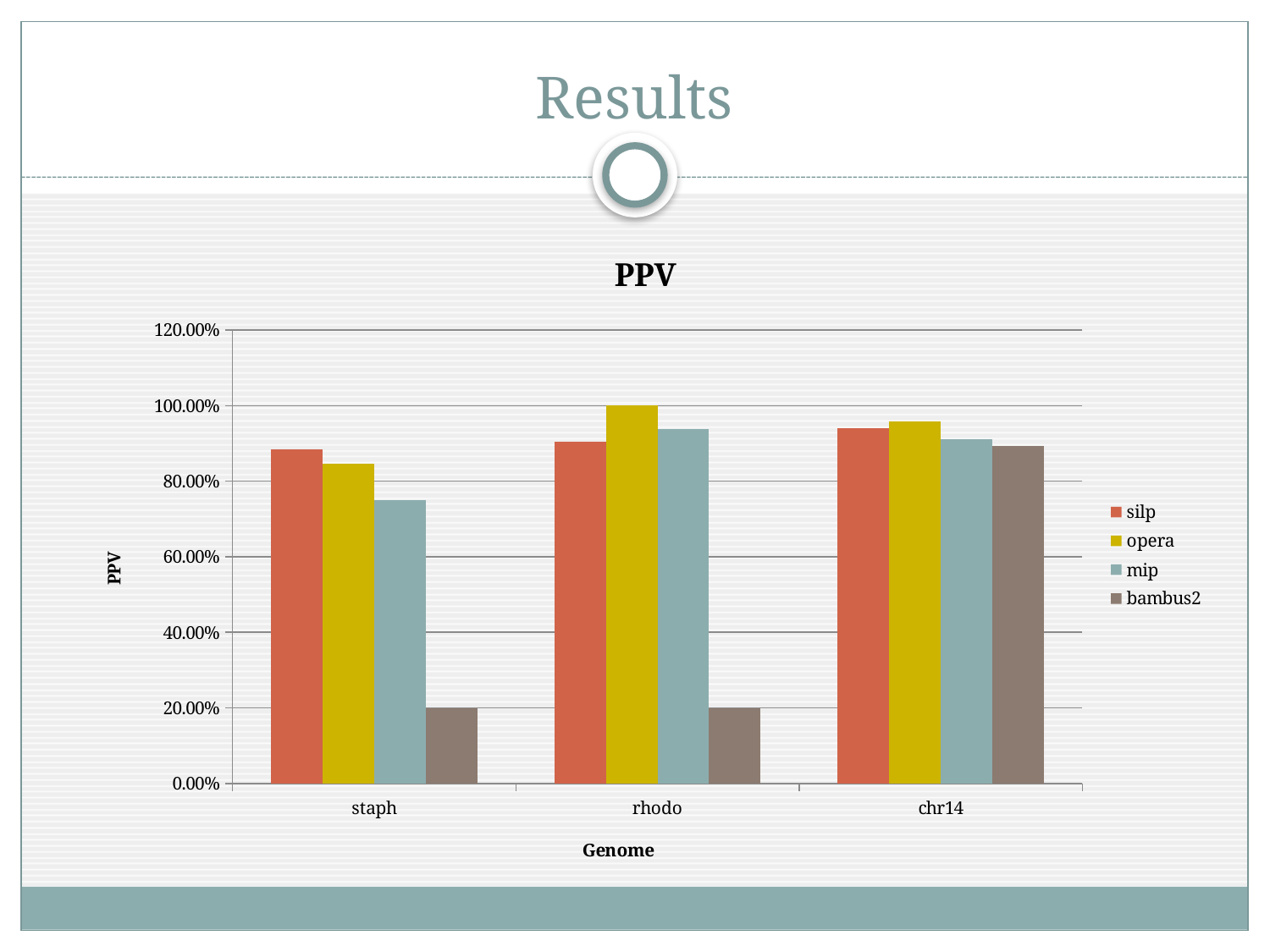
How many genome categories are shown on the x axis? 3 What is the PPV value for opera on the rhodo genome? 100.00% What is the PPV value for bambus2 on the rhodo genome? 20.00% Which series has the highest PPV for the rhodo genome? opera How many series does the legend list? 4 Is the PPV value for mip on the staph genome greater or less than 80.00%? less For the staph genome, which has a higher PPV: silp or mip? silp What is the title of the chart? PPV Which series has the lowest PPV for the staph genome? bambus2 What kind of chart is shown on the slide? bar chart Is the PPV value for bambus2 on the chr14 genome greater or less than 80.00%? greater What is the PPV value for bambus2 on the staph genome? 20.00%